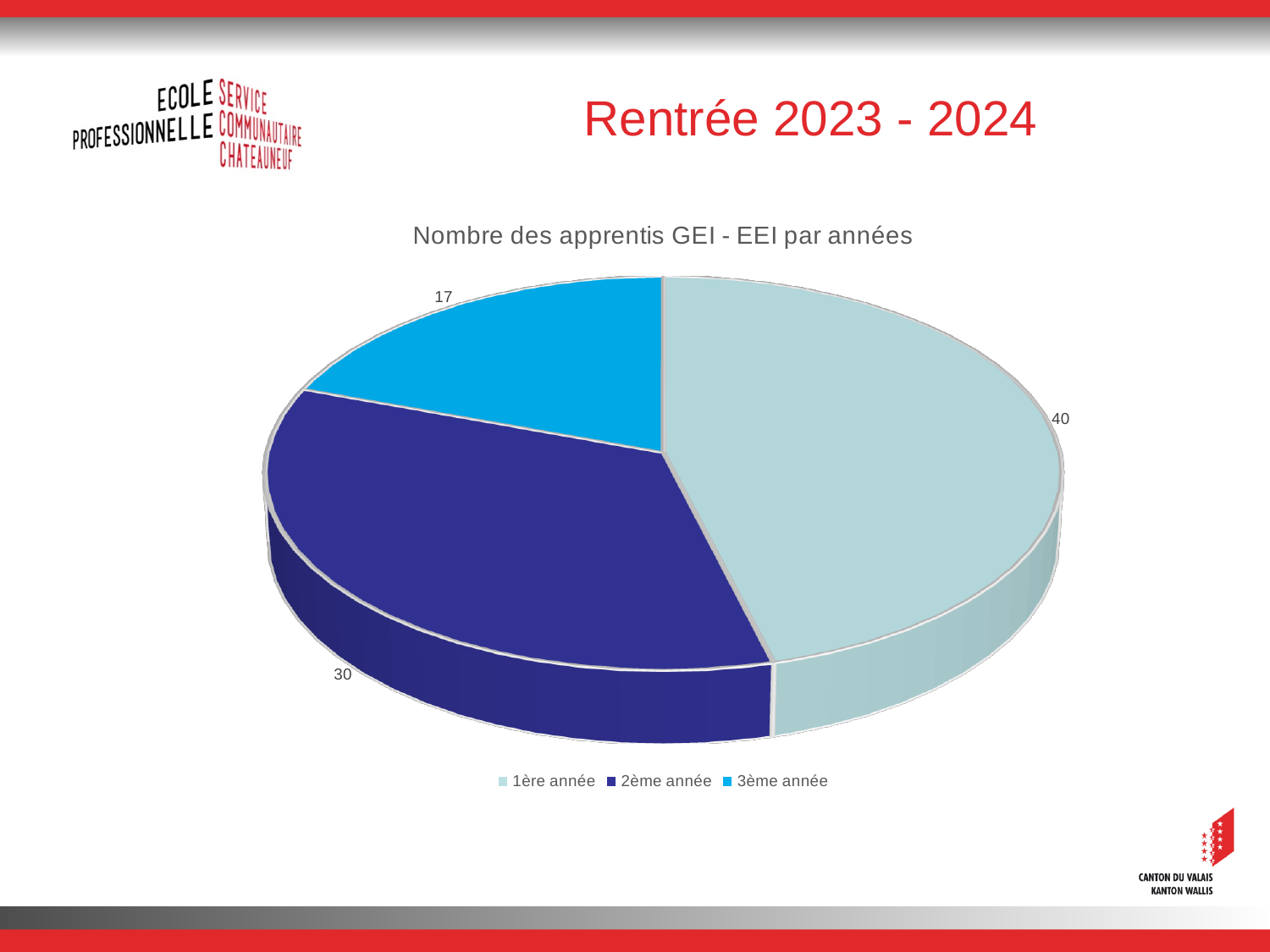
What is the title of the chart? Nombre des apprentis GEI - EEI par années Which is larger, the value for 2ème année or the value for 3ème année? 2ème année Which year has the smallest number of apprentices? 3ème année What type of chart is shown on the slide? pie chart What is the value for 1ère année? 40 Which year has the largest number of apprentices? 1ère année What is the value for 3ème année? 17 What is the total number of apprentices across all three years? 87 What is the value for 2ème année? 30 How many slices does the pie chart have? 3 What is the difference between the values for 1ère année and 3ème année? 23 How many series does the legend list? 3